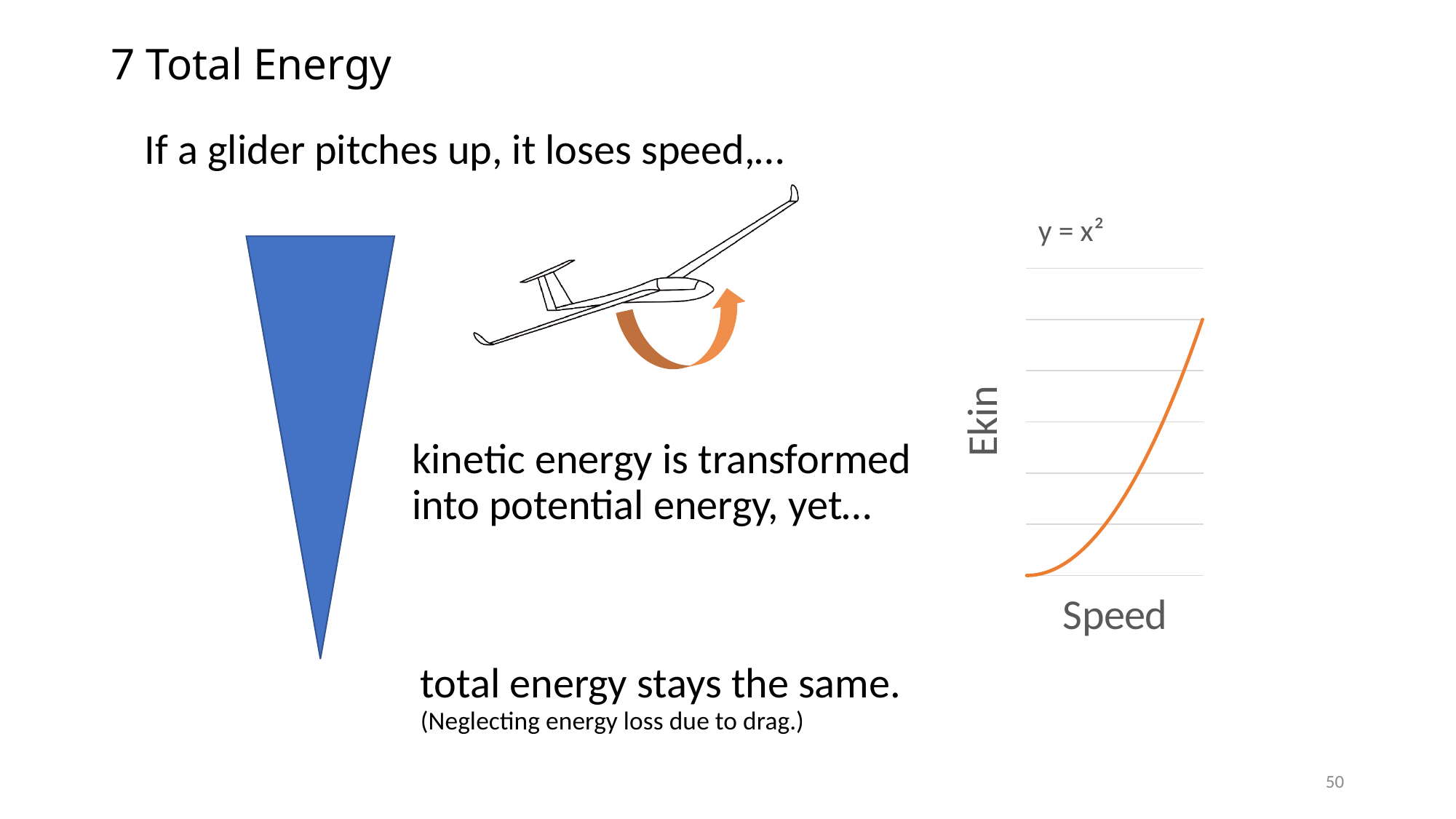
What is the title of the chart on the right of the slide? y = x² How many lines are plotted on the chart? 1 What is the label of the vertical axis of the chart? Ekin What is the label of the horizontal axis of the chart? Speed What kind of chart is shown on the right of the slide? line chart Does the plotted line rise or fall as Speed increases? rise